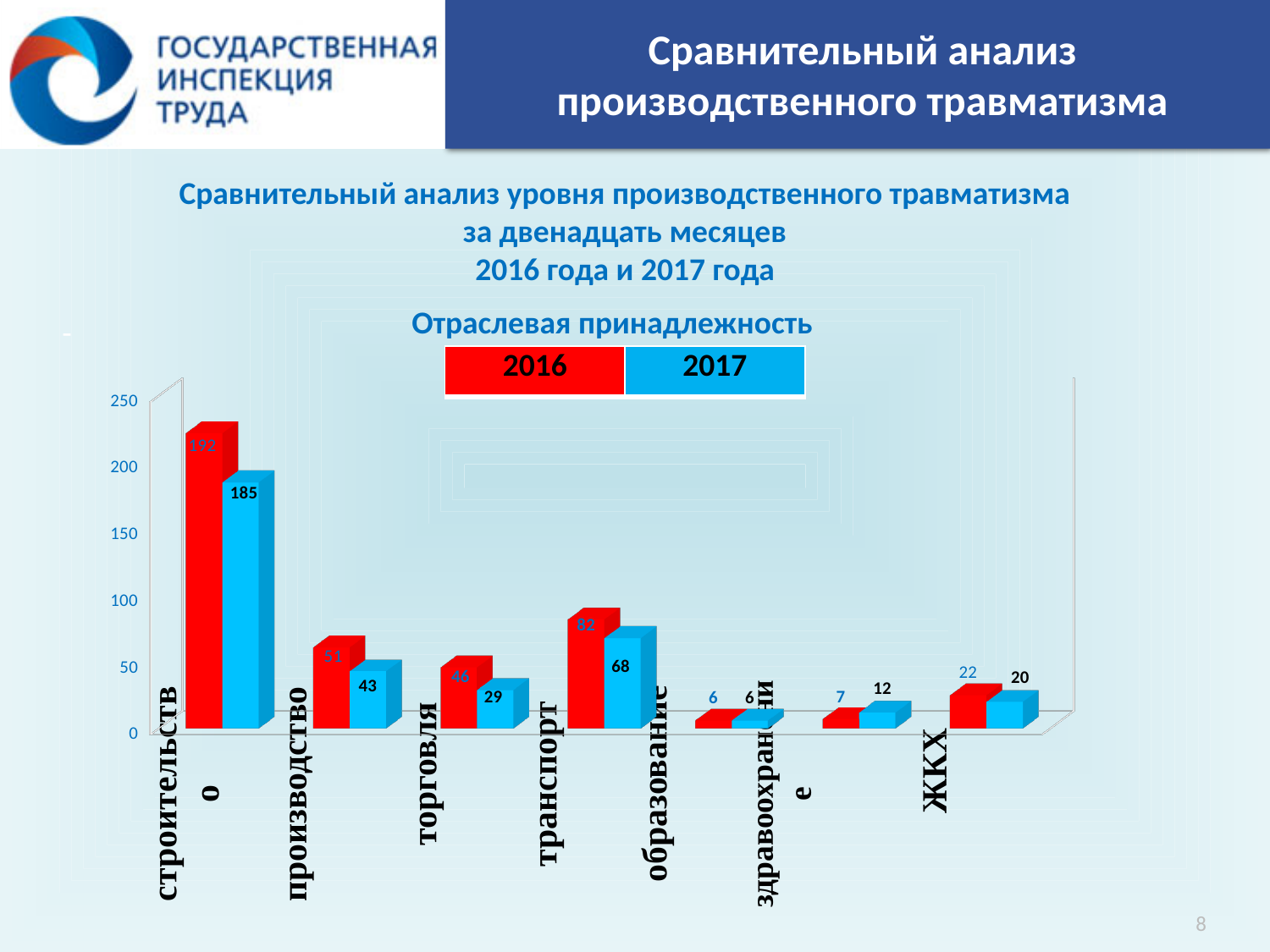
How many series does the legend list? 2 What type of chart is shown on the slide? bar chart What is the difference between the 2016 and 2017 values for торговля? 17 What is the 2016 value for ЖКХ? 22 What is the 2017 value for здравоохранение? 12 What is the 2017 value for строительство? 185 Which category has the highest 2016 value? строительство What is the 2017 value for транспорт? 68 Which is larger for здравоохранение, the 2016 value or the 2017 value? 2017 Which colour represents the 2017 series in the legend? blue How many industry categories are shown on the x axis? 7 Is the 2016 value for строительство greater or less than 150? greater